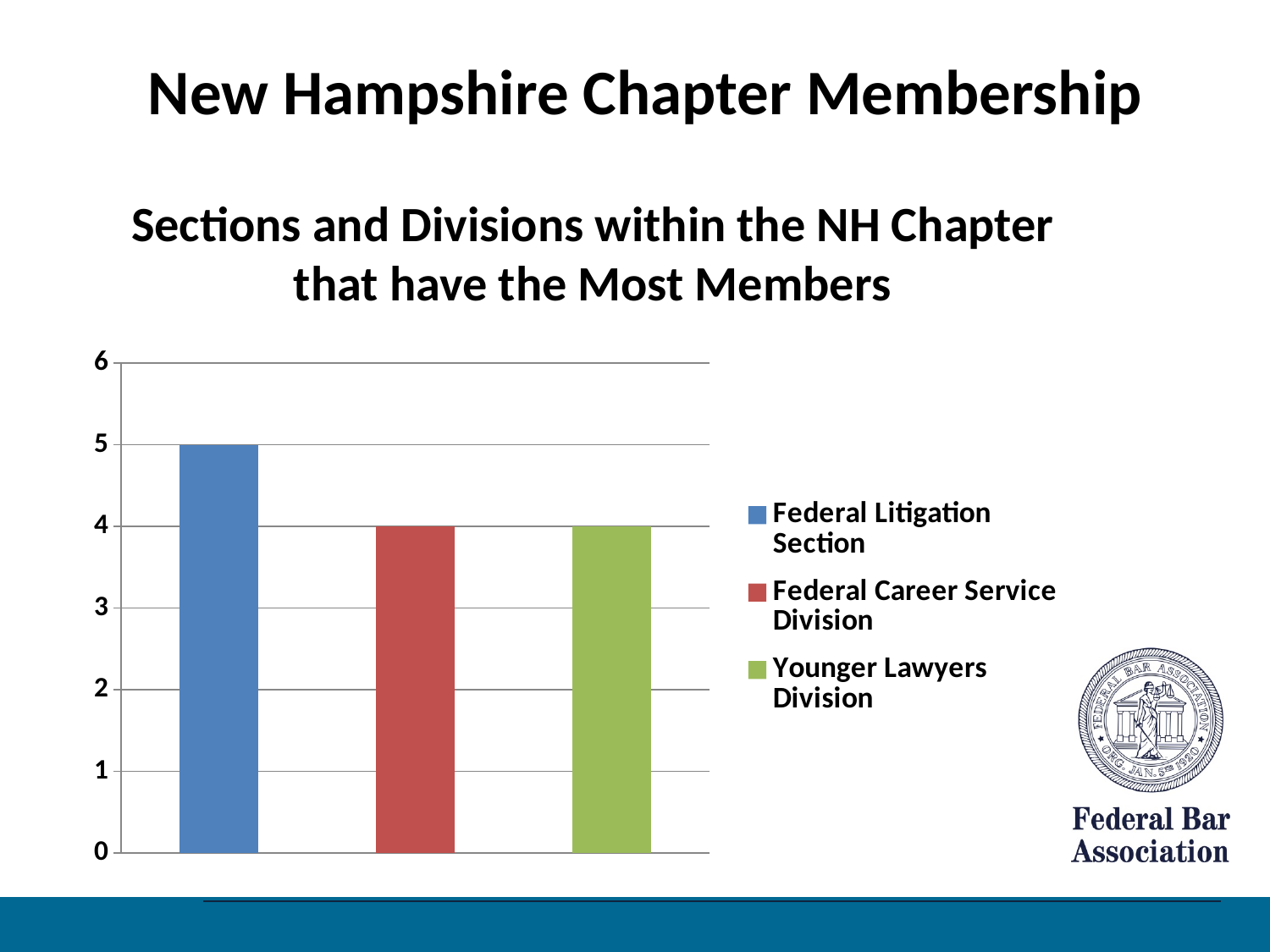
What is the value for the Federal Career Service Division? 4 Which is larger, the value for the Federal Litigation Section or the value for the Younger Lawyers Division? Federal Litigation Section What is the value for the Federal Litigation Section? 5 Is the value for the Younger Lawyers Division greater or less than 5? less What colour is the bar for the Younger Lawyers Division? Green Which section or division has the highest value? Federal Litigation Section How many bars are plotted in the chart? 3 What kind of chart is shown on the slide? Bar chart What is the value for the Younger Lawyers Division? 4 What is the difference between the values for the Federal Litigation Section and the Federal Career Service Division? 1 Is the value for the Federal Litigation Section greater or less than 4? greater How many entries does the legend list? 3